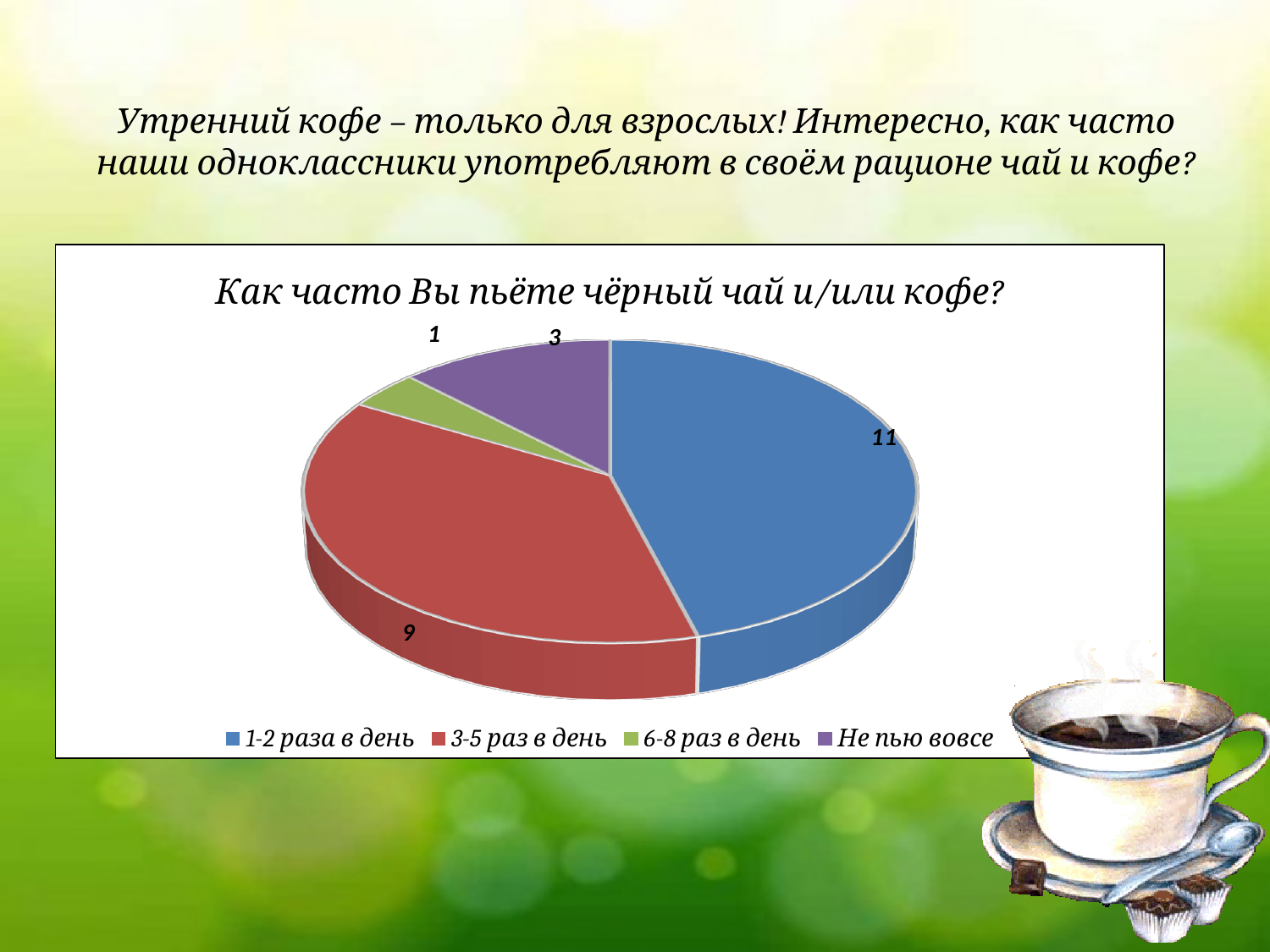
What is the value for "Не пью вовсе"? 3 What is the value for "3-5 раз в день"? 9 Which category has the largest slice? 1-2 раза в день What is the value for "1-2 раза в день"? 11 What is the title of the chart? Как часто Вы пьёте чёрный чай и/или кофе? What is the value for "6-8 раз в день"? 1 What share of the pie does "3-5 раз в день" represent? 37.5% What is the difference between the values for "1-2 раза в день" and "3-5 раз в день"? 2 Which category has the smallest slice? 6-8 раз в день What kind of chart is shown on the slide? Pie chart Which is larger, the value for "Не пью вовсе" or the value for "6-8 раз в день"? Не пью вовсе How many categories does the pie chart have? 4